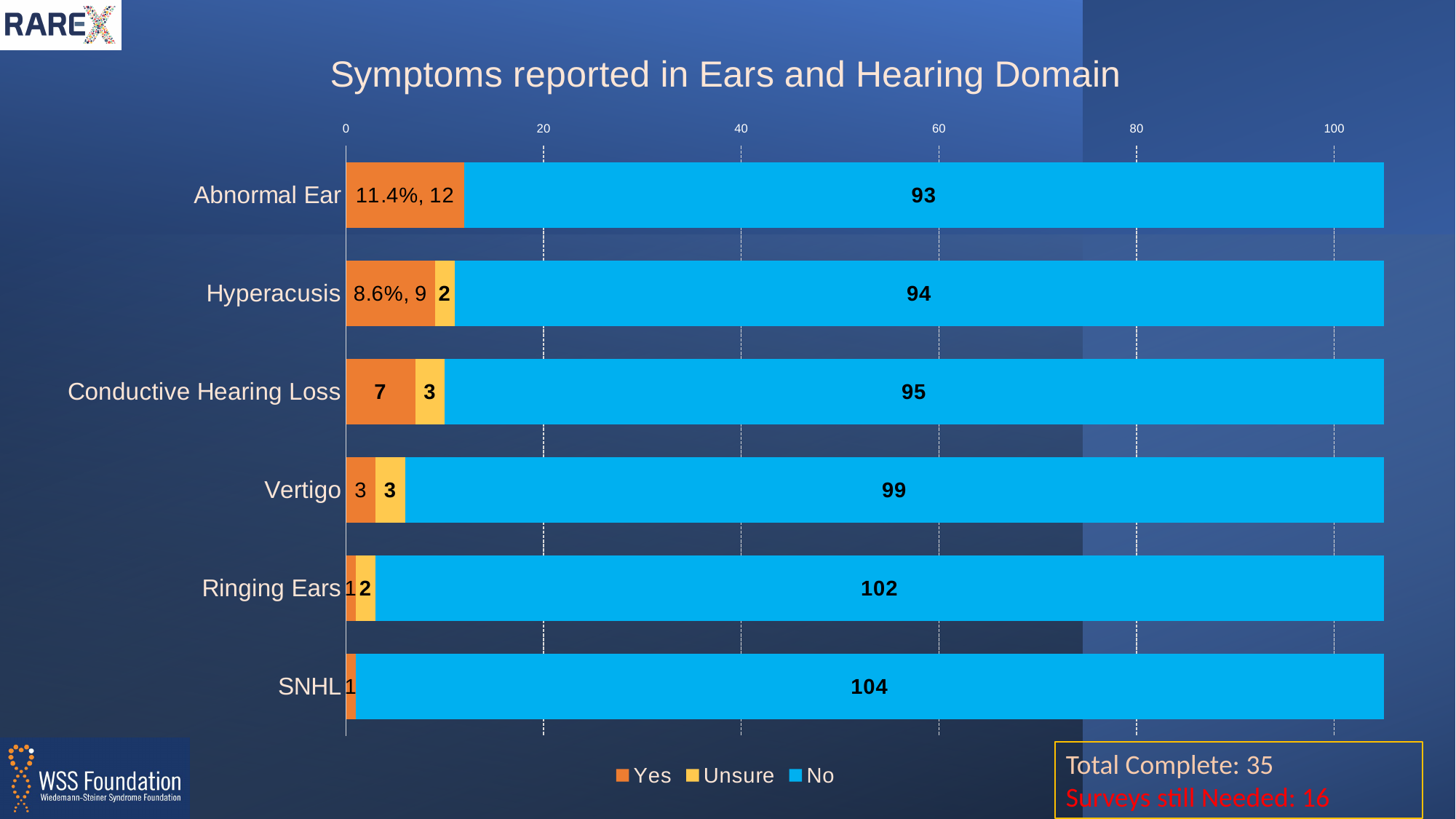
Which category has the highest 'No' value? SNHL What is the total of the stacked bar for Conductive Hearing Loss? 105 How many symptom categories are plotted in the chart? 6 How many series does the legend list? 3 What is the 'Yes' value for Conductive Hearing Loss? 7 What kind of chart is shown on the slide? bar chart What is the 'No' value for Vertigo? 99 What is the difference between the 'No' value for SNHL and the 'No' value for Abnormal Ear? 11 Which has a larger 'Yes' value, Abnormal Ear or Hyperacusis? Abnormal Ear What percentage is shown for the 'Yes' segment of Abnormal Ear? 11.4% What is the 'Unsure' value for Hyperacusis? 2 Which category has the lowest 'No' value? Abnormal Ear